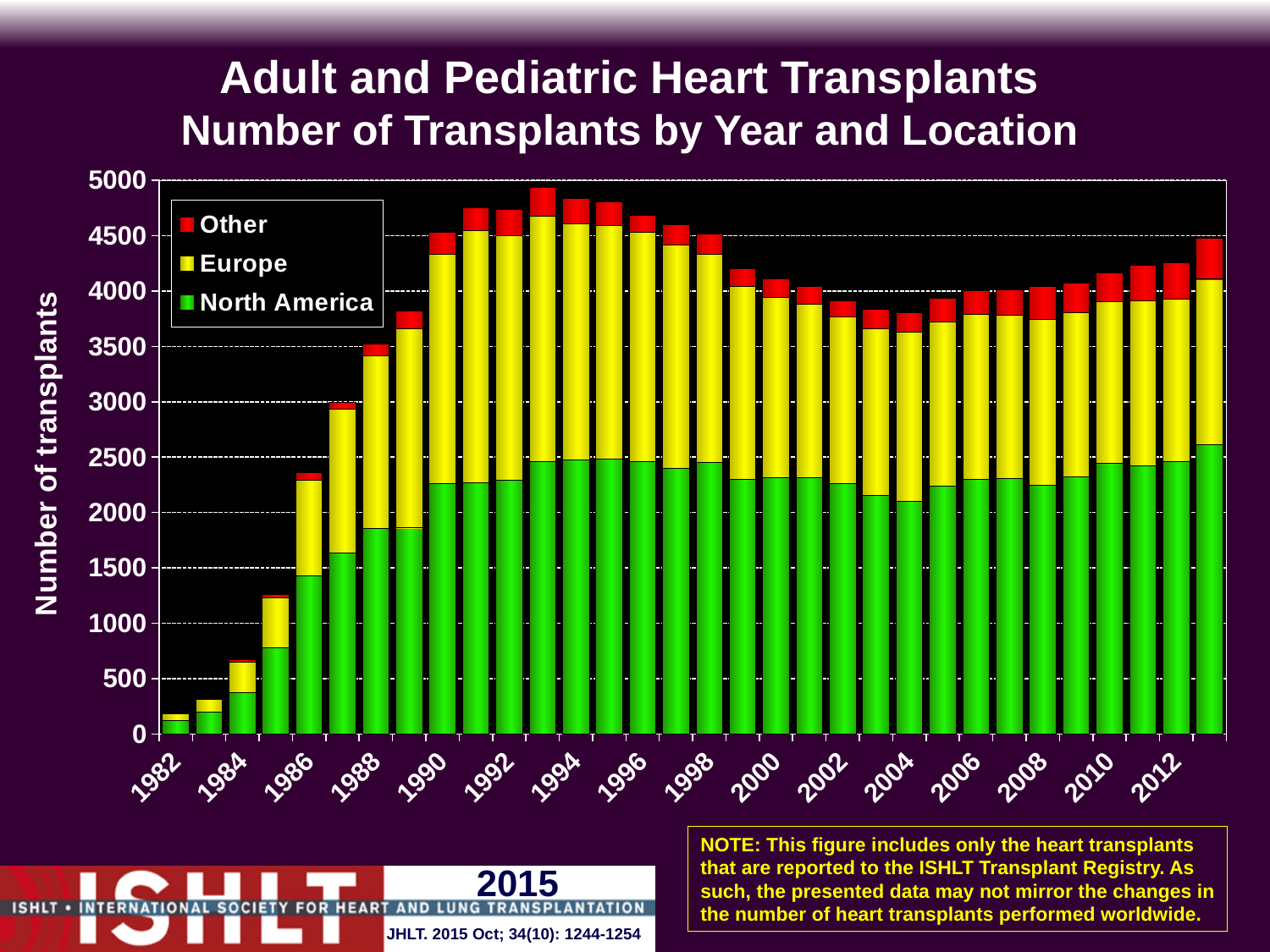
Is the total number of transplants in 2004 greater or less than 4000? less Is the North America value in 2013 greater or less than 2000? greater Is the total number of transplants in 1982 greater or less than 500? less Which year has the lowest total number of transplants? 1982 How many series does the legend list? 3 What is the label of the y axis? Number of transplants Do the total number of transplants rise or fall from 1982 to 1993? rise Which year has a larger total number of transplants, 1990 or 2000? 1990 What kind of chart is shown on the slide? Stacked bar chart Which year has the highest total number of transplants? 1993 Which series are listed in the legend? Other, Europe, North America